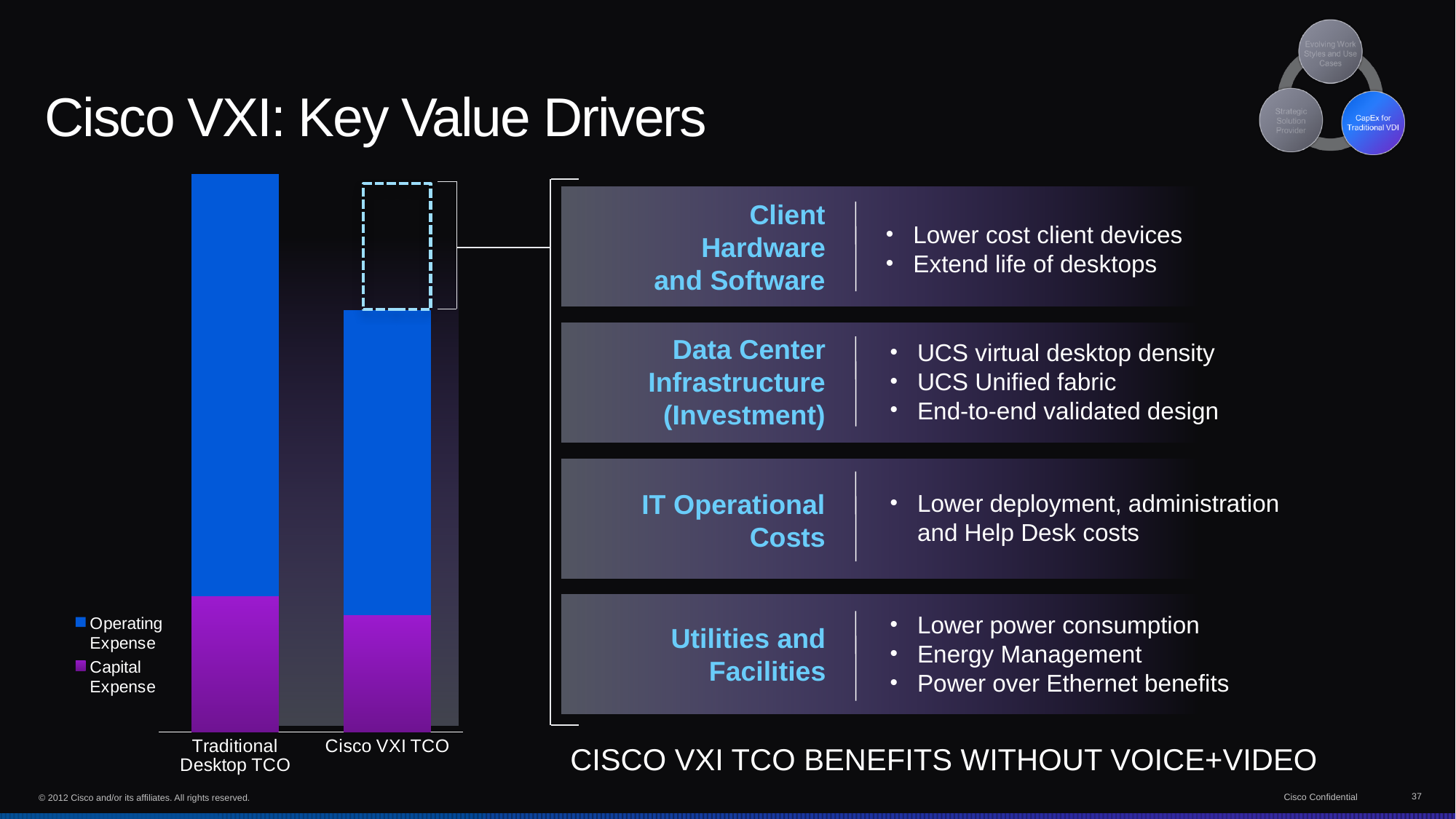
Which category has the shorter total bar? Cisco VXI TCO Which colour represents Capital Expense in the chart's legend? Purple In the Traditional Desktop TCO bar, which segment is larger, Operating Expense or Capital Expense? Operating Expense Is the Operating Expense segment larger for Traditional Desktop TCO or for Cisco VXI TCO? Traditional Desktop TCO What kind of chart is shown on the left of the slide? Stacked bar chart Which series is shown in blue in the chart? Operating Expense Does the total bar height rise or fall from Traditional Desktop TCO to Cisco VXI TCO? Fall In the Cisco VXI TCO bar, which segment is larger, Operating Expense or Capital Expense? Operating Expense How many series does the chart's legend list? 2 How many categories are shown on the x axis of the chart? 2 Which category has the taller total bar, Traditional Desktop TCO or Cisco VXI TCO? Traditional Desktop TCO